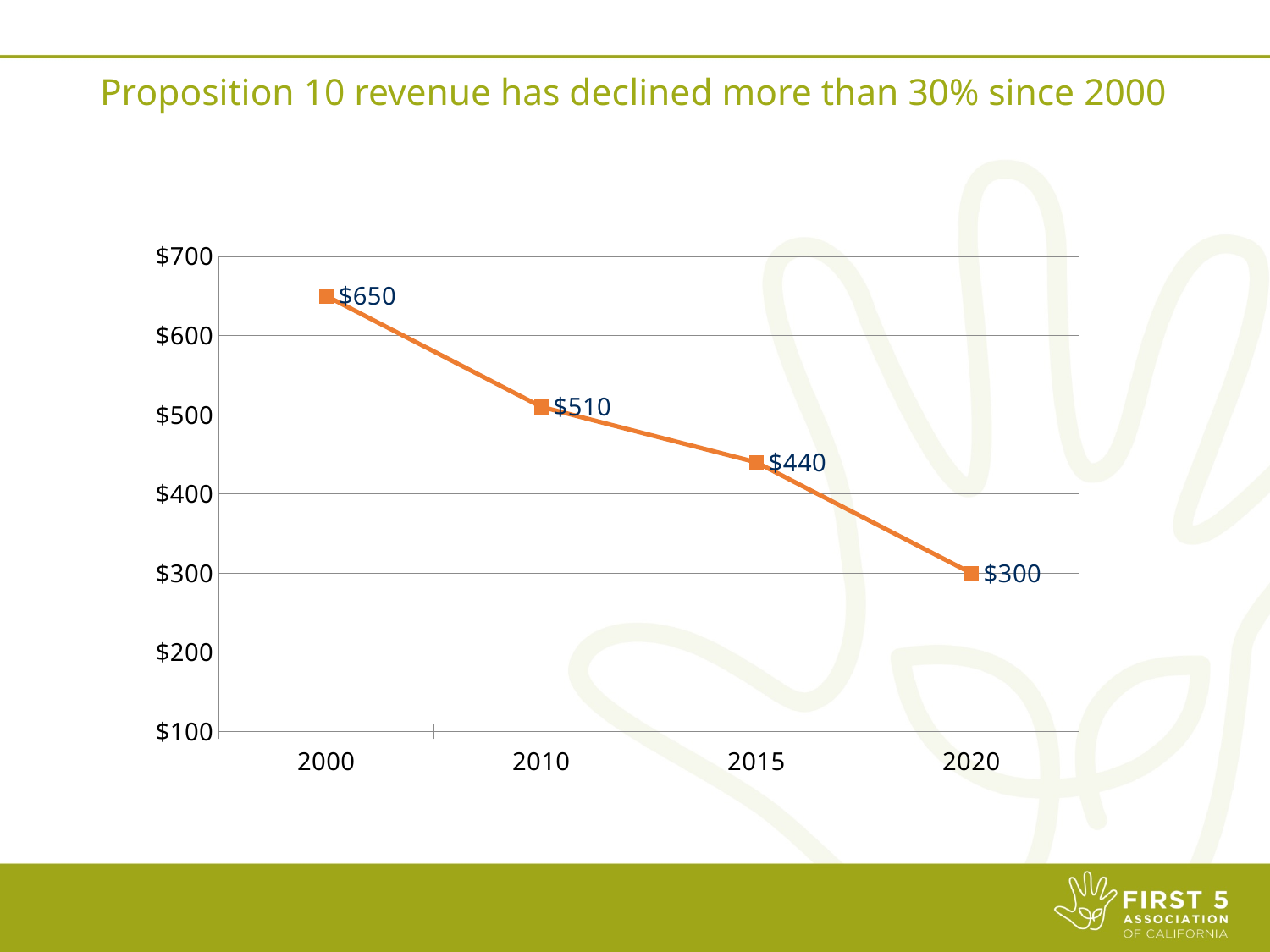
What is the value for 2020? $300 What is the value for 2010? $510 Which year has the lowest value? 2020 Do the values rise or fall from 2000 to 2020? Fall Which year has the highest value? 2000 What kind of chart is shown on the slide? Line chart How many data points are plotted on the chart? 4 What is the value for 2015? $440 What is the difference between the values for 2010 and 2015? $70 What is the difference between the values for 2000 and 2020? $350 What is the value for 2000? $650 Which is larger, the value for 2010 or the value for 2015? 2010